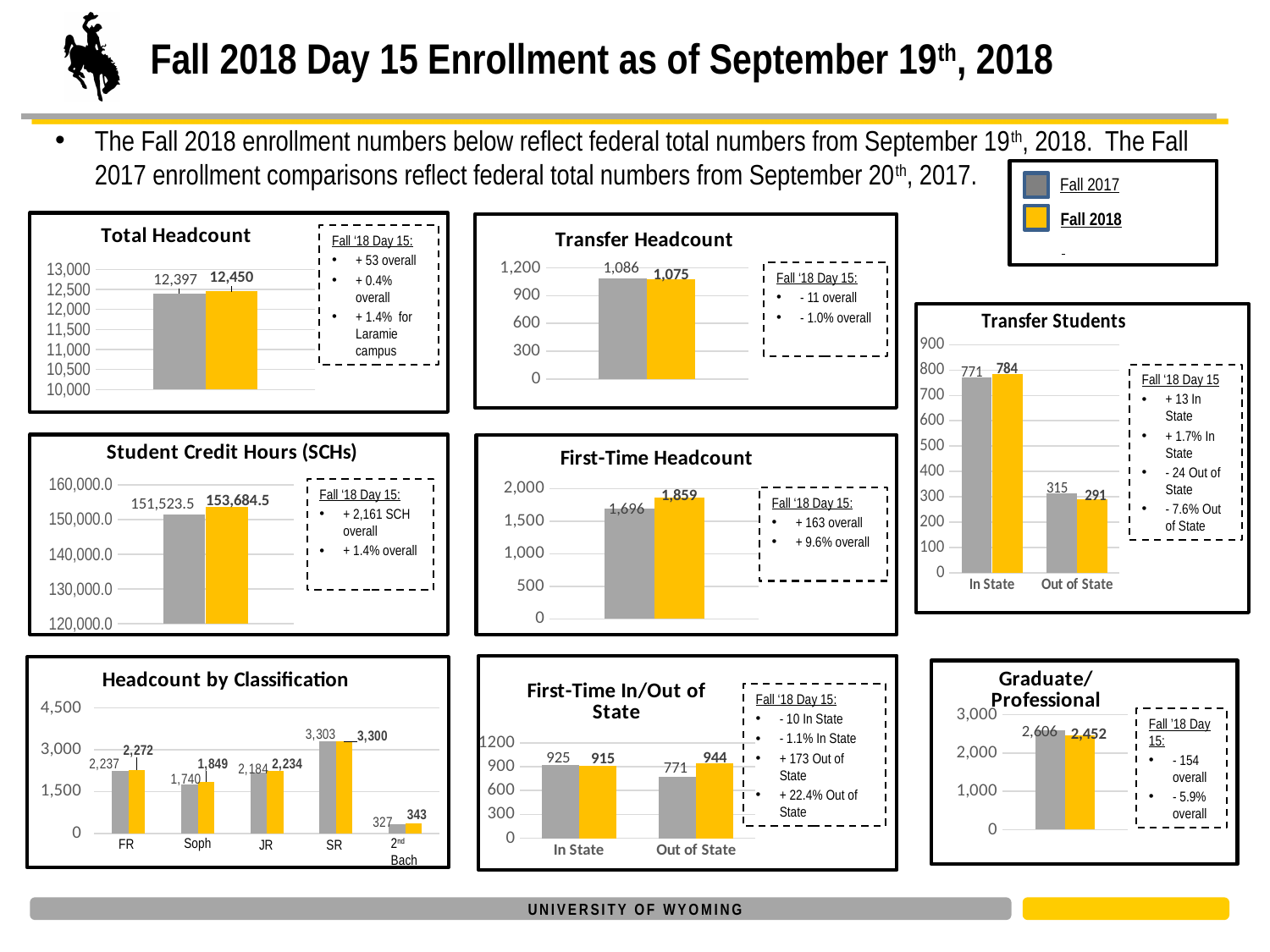
In the First-Time In/Out of State chart, what is the Fall 2018 value for Out of State? 944 In the Transfer Students chart, what is the Fall 2018 value for Out of State? 291 In the Transfer Headcount chart, what is the Fall 2017 value? 1,086 In the Headcount by Classification chart, which classification has the highest Fall 2018 headcount? SR What type of chart is the Total Headcount chart? Bar chart In the Graduate/Professional chart, what is the difference between the Fall 2017 and Fall 2018 values? 154 In the Student Credit Hours (SCHs) chart, what is the difference between the Fall 2018 and Fall 2017 values? 2,161.0 In the First-Time Headcount chart, which is larger, the Fall 2017 or the Fall 2018 value? Fall 2018 In the Headcount by Classification chart, how many classification categories are shown? 5 In the Total Headcount chart, what is the Fall 2018 value? 12,450 In the Headcount by Classification chart, which classification has the lowest Fall 2017 headcount? 2nd Bach How many series does the legend at the top right of the slide list? 2